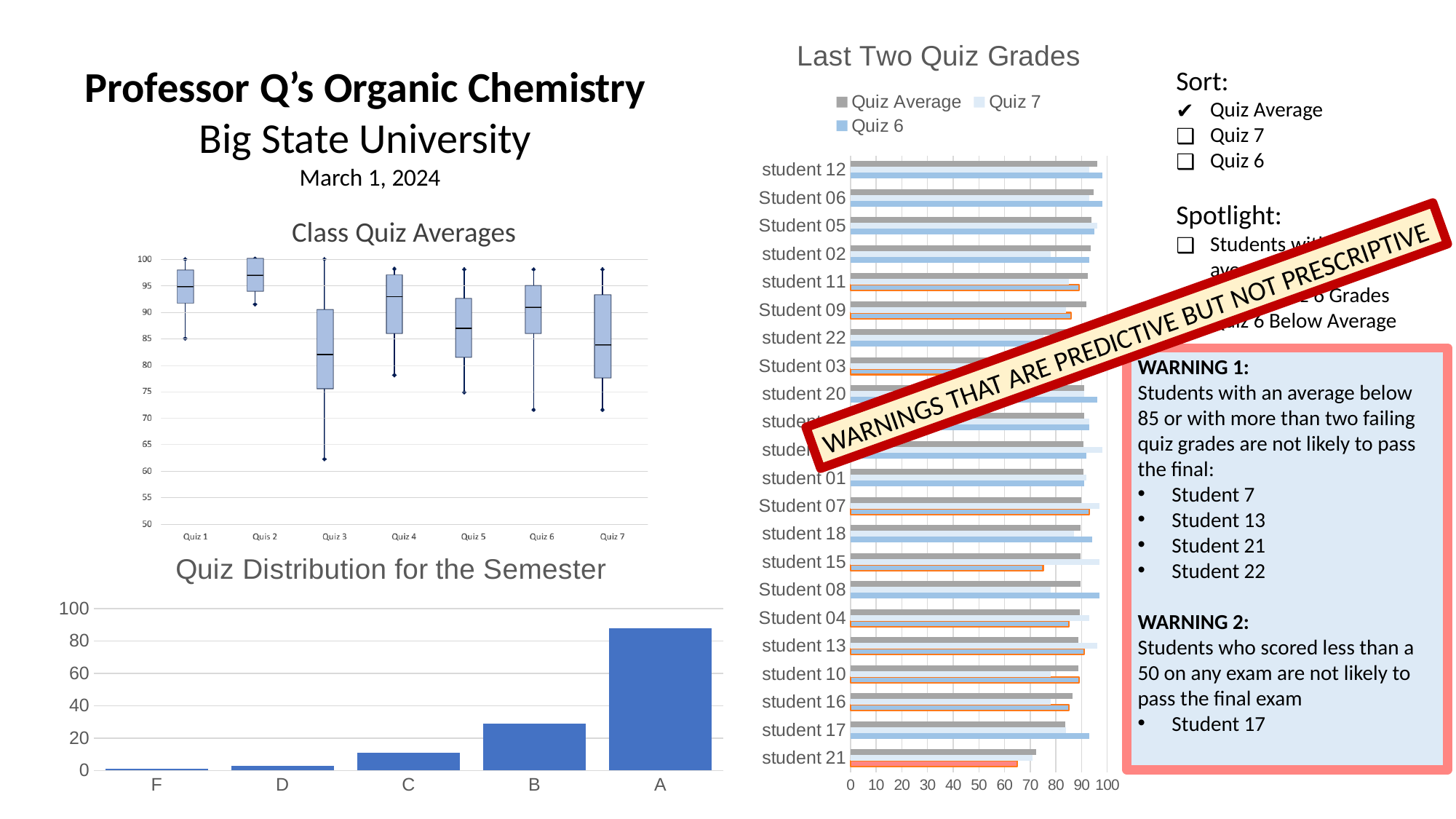
In "Quiz Distribution for the Semester", do the values rise or fall from F to A along the x axis? rise In "Quiz Distribution for the Semester", which grade category has the highest value? A How many grade categories are shown in "Quiz Distribution for the Semester"? 5 In "Class Quiz Averages", which quiz has the lowest minimum score? Quiz 3 In "Quiz Distribution for the Semester", which grade category has the lowest value? F In "Quiz Distribution for the Semester", is the value for C greater or less than 20? less How many quizzes are shown in the "Class Quiz Averages" chart? 7 In "Class Quiz Averages", is the median for Quiz 1 greater or less than 90? greater What kind of chart is "Quiz Distribution for the Semester"? bar chart How many series does the legend of "Last Two Quiz Grades" list? 3 In "Quiz Distribution for the Semester", is the value for A greater or less than 80? greater